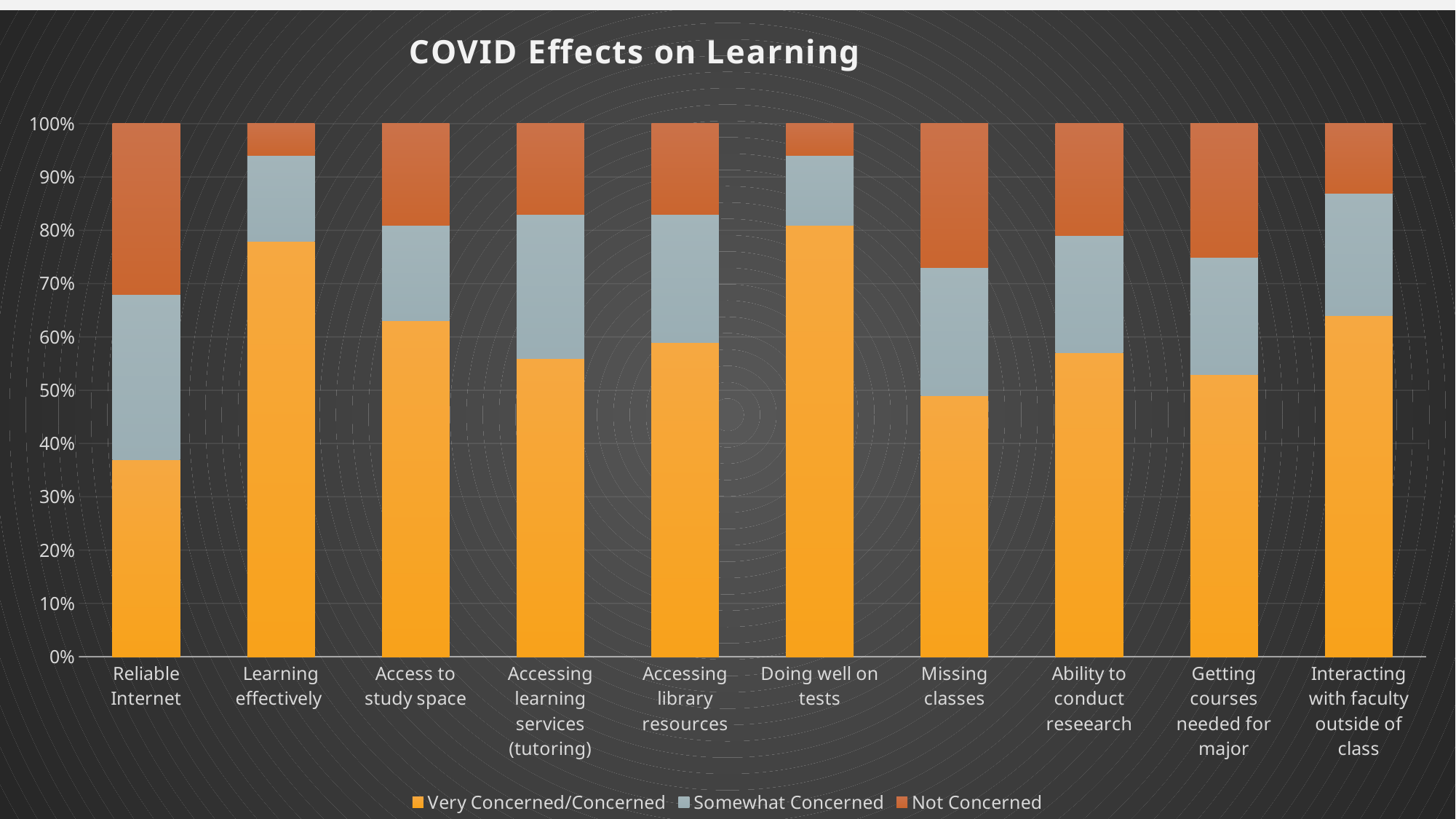
Which series is shown in orange/yellow at the bottom of each bar? Very Concerned/Concerned Which category has the lowest Very Concerned/Concerned share? Reliable Internet What is the total of the stacked bar for Doing well on tests? 100% How many categories are shown along the x axis? 10 Is the Very Concerned/Concerned value for Missing classes greater or less than 60%? less What is the title of the chart? COVID Effects on Learning Is the Very Concerned/Concerned value for Reliable Internet greater or less than 40%? less How many series does the legend list? 3 Which category has the largest Not Concerned share? Reliable Internet What kind of chart is shown on the slide? Stacked bar chart Which has a larger Very Concerned/Concerned share: Reliable Internet or Learning effectively? Learning effectively Is the Very Concerned/Concerned value for Learning effectively greater or less than 70%? greater